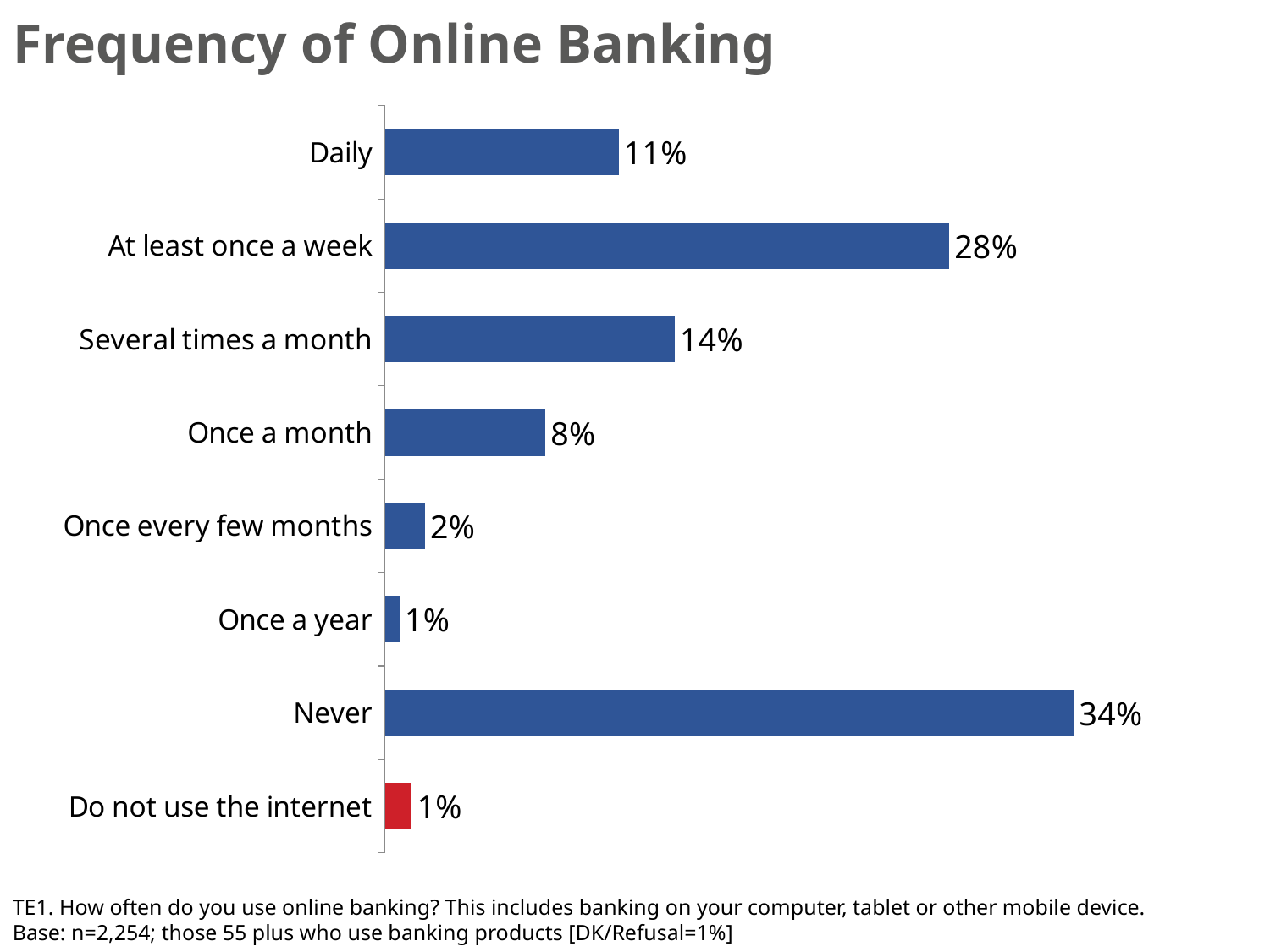
What kind of chart is shown on the slide? Bar chart What is the difference between 'Several times a month' and 'Once a month'? 6% What percentage of respondents use online banking daily? 11% Which is larger, 'Daily' or 'Several times a month'? Several times a month What is the title of the chart? Frequency of Online Banking What is the difference between 'Never' and 'At least once a week'? 6% What is the value for 'At least once a week'? 28% Which category's bar is coloured red instead of blue? Do not use the internet What percentage of respondents never use online banking? 34% Which category has the highest value? Never What is the value for 'Once every few months'? 2% How many categories are shown in the chart? 8